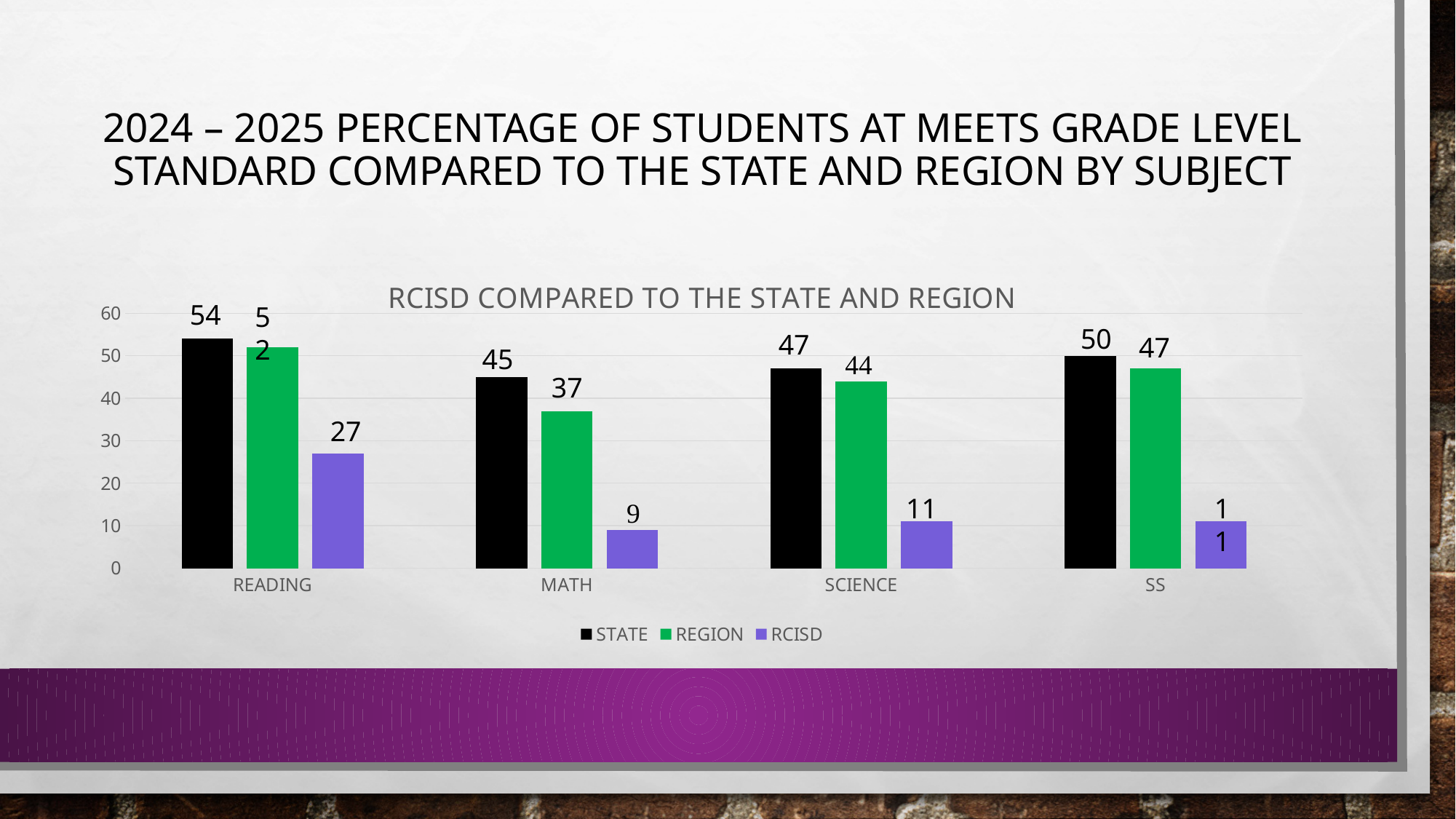
In which subject is the RCISD value lowest? MATH Which is larger for SCIENCE, the STATE value or the REGION value? STATE What is the difference between the STATE and RCISD values for MATH? 36 What is the RCISD value for READING? 27 What type of chart is shown on the slide? bar chart In which subject is the STATE value highest? READING What is the STATE value for SS? 50 How many subject categories are shown on the x axis? 4 What is the RCISD value for MATH? 9 What is the REGION value for SCIENCE? 44 How many series does the legend list? 3 What is the STATE value for MATH? 45